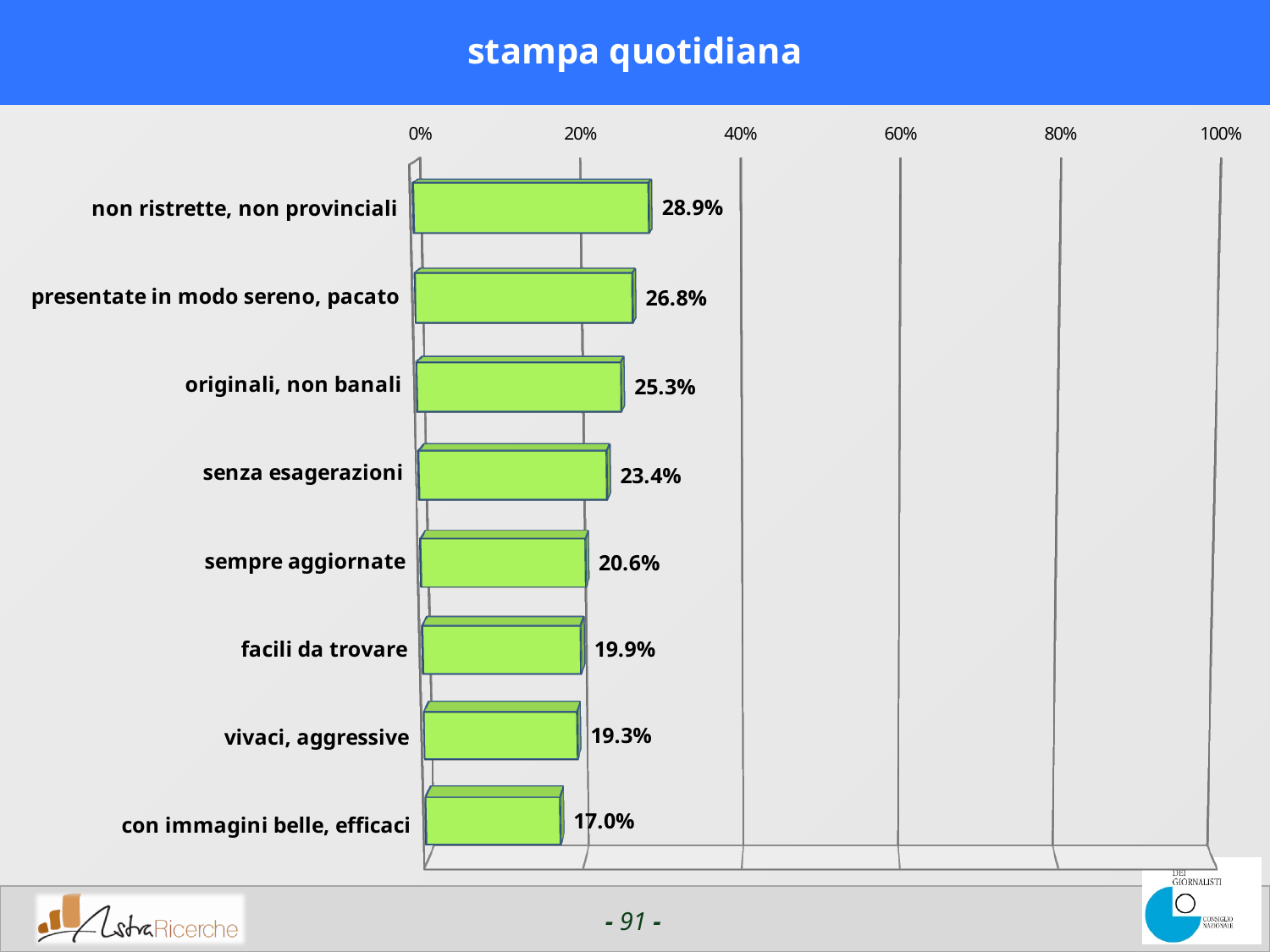
What is the value for "sempre aggiornate"? 20.6% What is the difference between "presentate in modo sereno, pacato" and "originali, non banali"? 1.5% What is the title of the slide? stampa quotidiana What is the value for "con immagini belle, efficaci"? 17.0% Which category has the highest value? non ristrette, non provinciali Is the value for "vivaci, aggressive" greater or less than 20%? less What colour are the bars in the chart? green What kind of chart is shown on the slide? bar chart How many categories are shown in the chart? 8 What is the value for "non ristrette, non provinciali"? 28.9% Which category has the lowest value? con immagini belle, efficaci Which is larger, the value for "senza esagerazioni" or the value for "facili da trovare"? senza esagerazioni